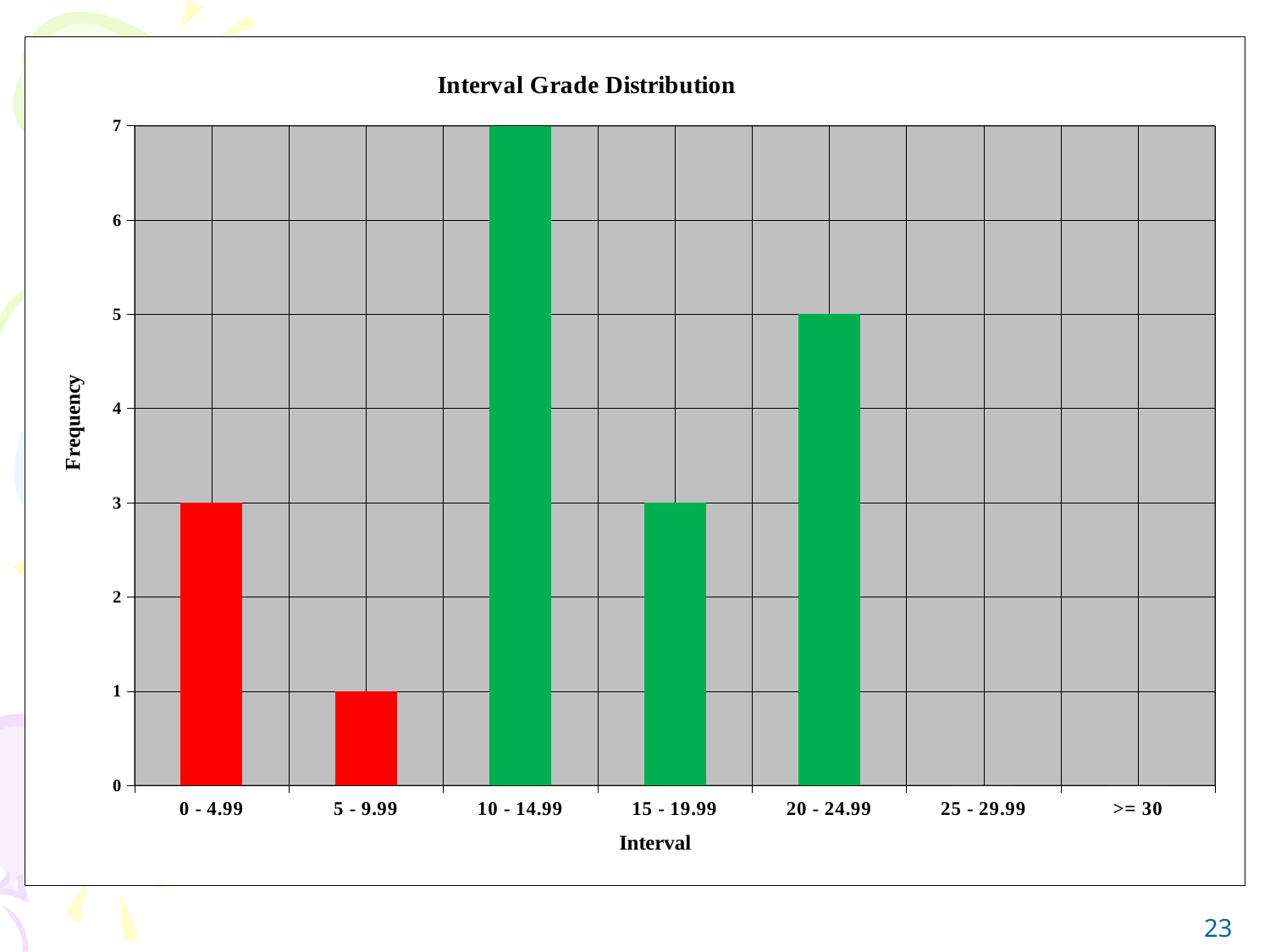
Which has a higher frequency, the 15 - 19.99 interval or the 20 - 24.99 interval? 20 - 24.99 What is the label of the y axis? Frequency What is the title of the chart? Interval Grade Distribution What is the frequency for the 5 - 9.99 interval? 1 What type of chart is shown on the slide? bar chart How many interval categories are labelled on the x axis? 7 Which interval has the highest frequency? 10 - 14.99 What is the frequency for the 0 - 4.99 interval? 3 What is the frequency for the 10 - 14.99 interval? 7 What is the difference in frequency between the 10 - 14.99 interval and the 20 - 24.99 interval? 2 Among the intervals with a visible bar, which has the lowest frequency? 5 - 9.99 What is the frequency for the 20 - 24.99 interval? 5